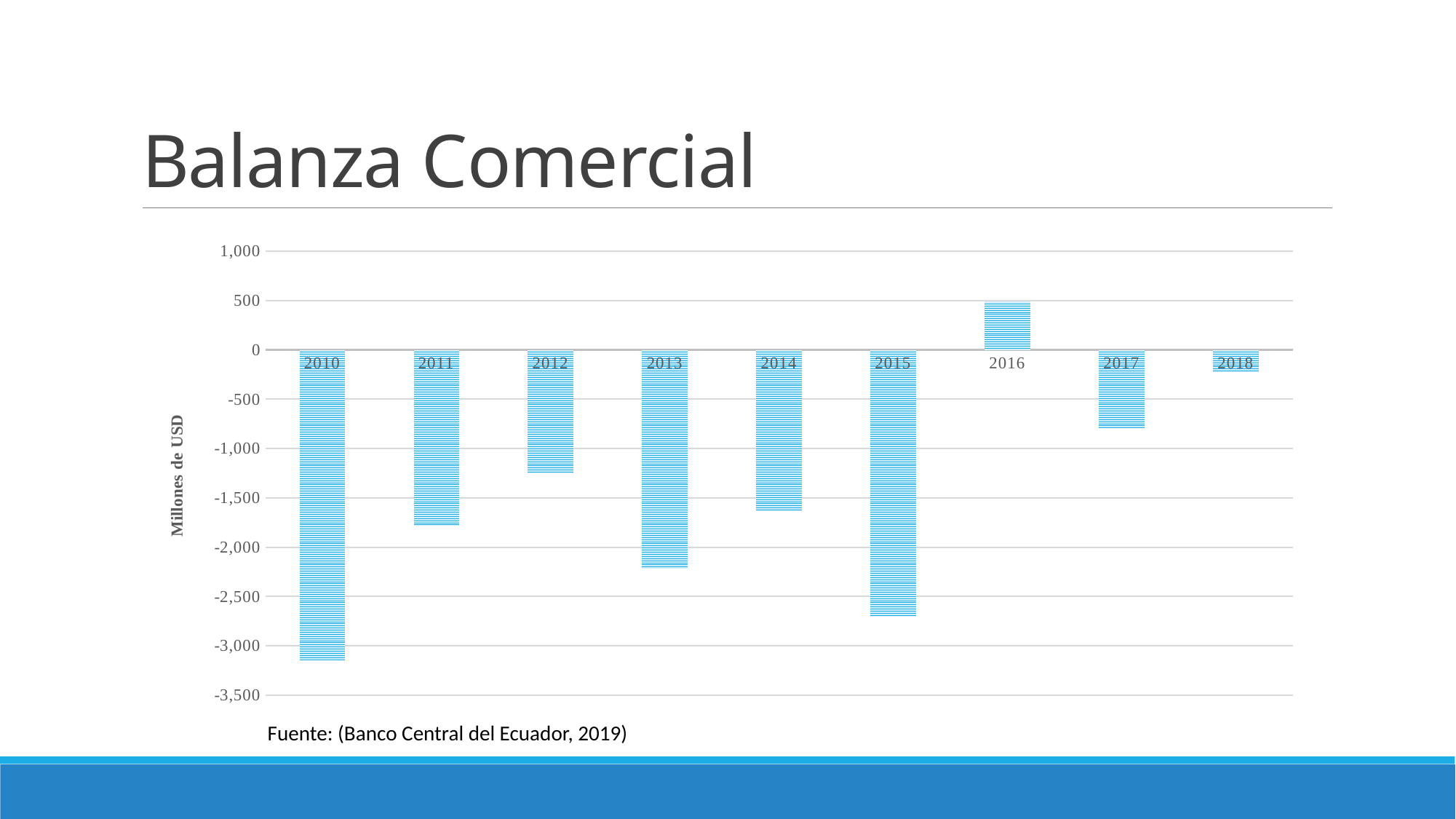
Which year has the larger value, 2012 or 2015? 2012 Is the value for 2012 greater or less than -1,500? greater Which year has the highest value on the chart? 2016 Which year has the lowest value on the chart? 2010 What is the label on the vertical axis of the chart? Millones de USD Which year has the larger value, 2013 or 2014? 2014 Is the value for 2015 greater or less than -2,500? less How many years are plotted on the chart? 9 Is the value for 2010 greater or less than -3,000? less Which is the only year with a positive trade balance on the chart? 2016 What kind of chart is shown on the slide? bar chart